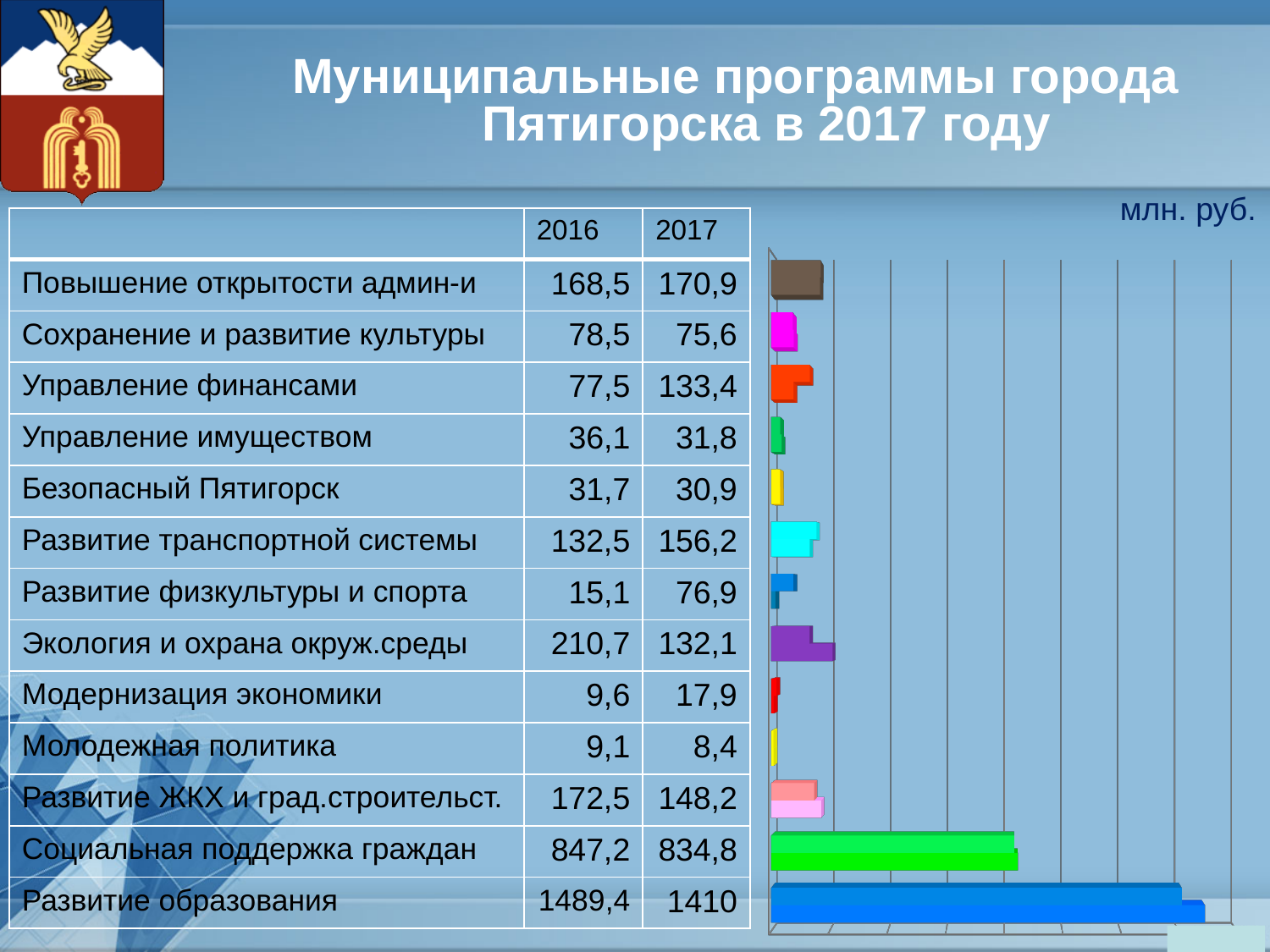
What kind of chart is shown on the right of the slide? bar chart What is the difference between the 2016 and 2017 values for Развитие образования? 79,4 What unit is indicated above the chart? млн. руб. Which is larger: the 2017 value for Социальная поддержка граждан or the 2017 value for Развитие образования? Развитие образования Which is larger for Развитие физкультуры и спорта: the 2016 value or the 2017 value? 2017 Which programme has the shortest bars in the chart? Молодежная политика What is the 2017 value for Управление финансами? 133,4 How many programme categories are plotted in the bar chart? 13 Which programme has the longest bars in the chart? Развитие образования What is the difference between the 2016 and 2017 values for Экология и охрана окруж.среды? 78,6 What is the 2016 value for Социальная поддержка граждан? 847,2 What is the 2017 value for Развитие образования? 1410